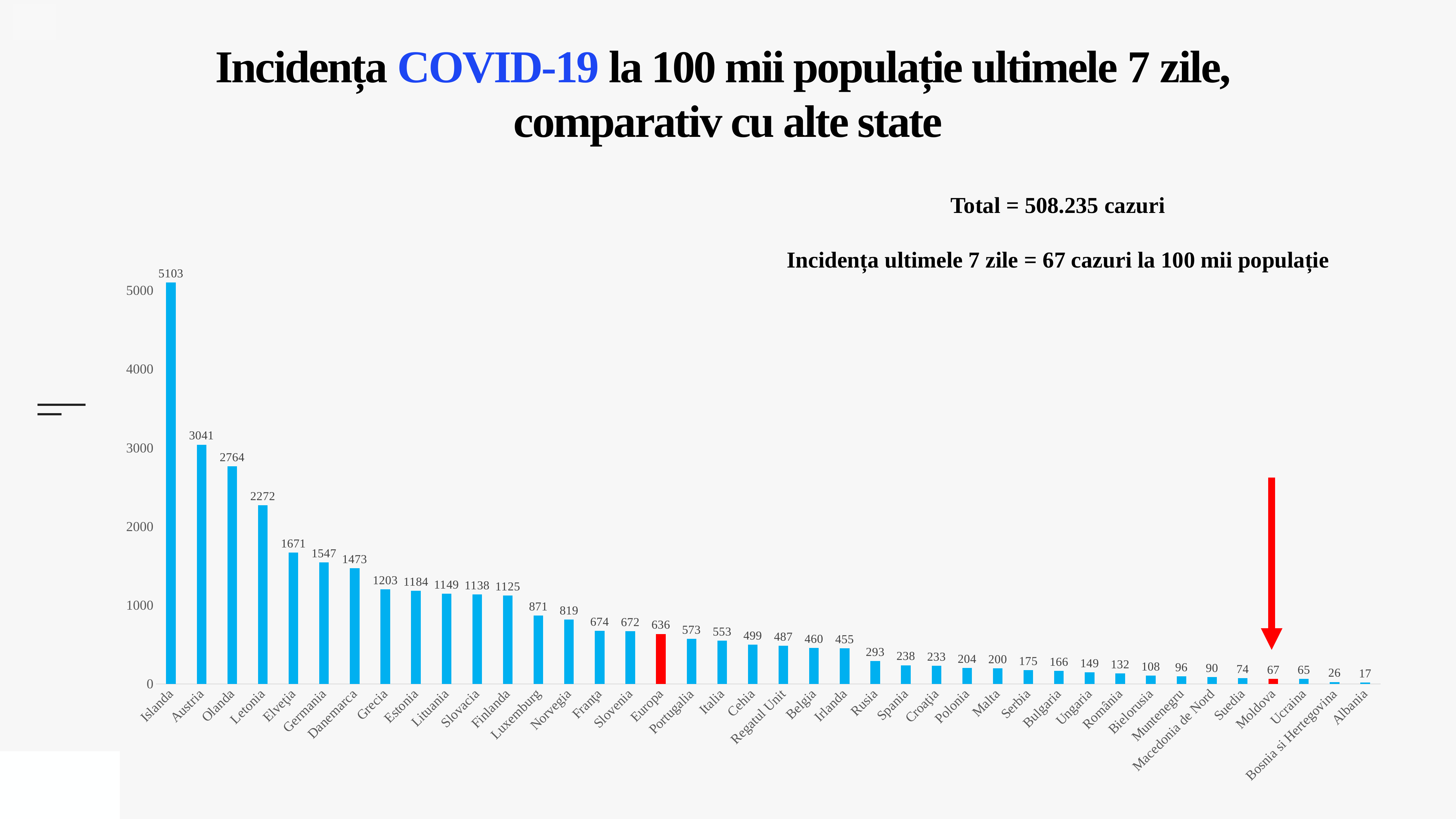
Which bar is coloured red instead of blue? Europa and Moldova Do the values rise or fall from left to right along the x axis? Fall What is the value for Europa? 636 What is the difference between the values for Austria and Olanda? 277 What is the value for Islanda? 5103 What is the value for Moldova? 67 Which has a larger value, Ucraina or Moldova? Moldova What is the value for România? 132 Which country has the highest value? Islanda What kind of chart is shown on the slide? Bar chart How many categories are shown on the x axis? 40 Which country has the lowest value? Albania